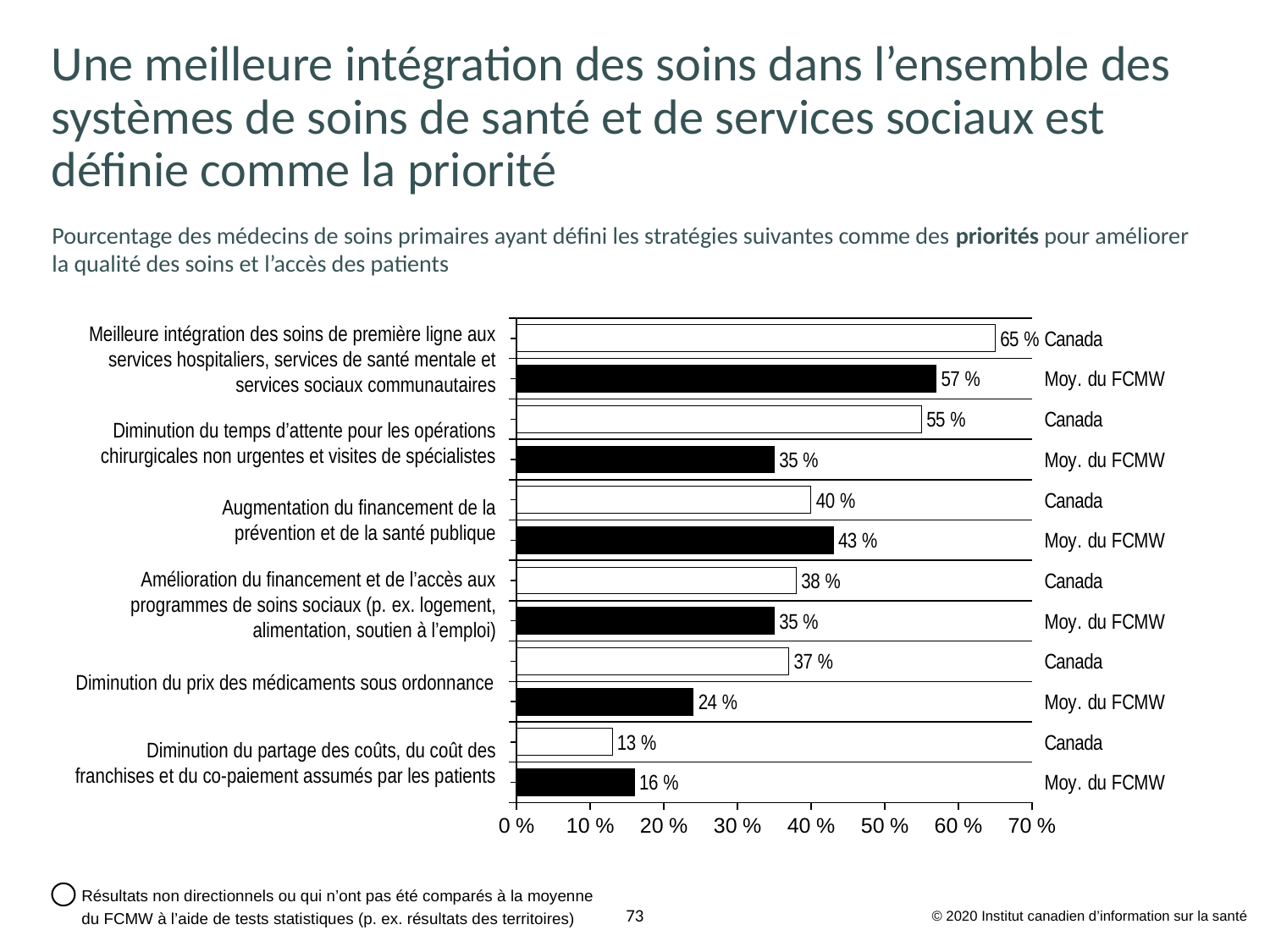
How many strategies (categories) are shown on the chart? 6 What is the difference between the Canada value and the Moy. du FCMW value for "Diminution du temps d'attente pour les opérations chirurgicales non urgentes et visites de spécialistes"? 20 % For "Diminution du prix des médicaments sous ordonnance", which is larger: the Canada value or the Moy. du FCMW value? Canada What is the Moy. du FCMW value for "Diminution du temps d'attente pour les opérations chirurgicales non urgentes et visites de spécialistes"? 35 % What is the Canada value for "Meilleure intégration des soins de première ligne aux services hospitaliers, services de santé mentale et services sociaux communautaires"? 65 % For "Augmentation du financement de la prévention et de la santé publique", which is larger: the Canada value or the Moy. du FCMW value? Moy. du FCMW Which strategy has the highest Canada value? Meilleure intégration des soins de première ligne aux services hospitaliers, services de santé mentale et services sociaux communautaires Which strategy has the lowest Canada value? Diminution du partage des coûts, du coût des franchises et du co-paiement assumés par les patients How many series are shown for each strategy on the chart? 2 What is the Moy. du FCMW value for "Diminution du partage des coûts, du coût des franchises et du co-paiement assumés par les patients"? 16 % What is the Canada value for "Diminution du prix des médicaments sous ordonnance"? 37 % What kind of chart is shown on the slide? Bar chart